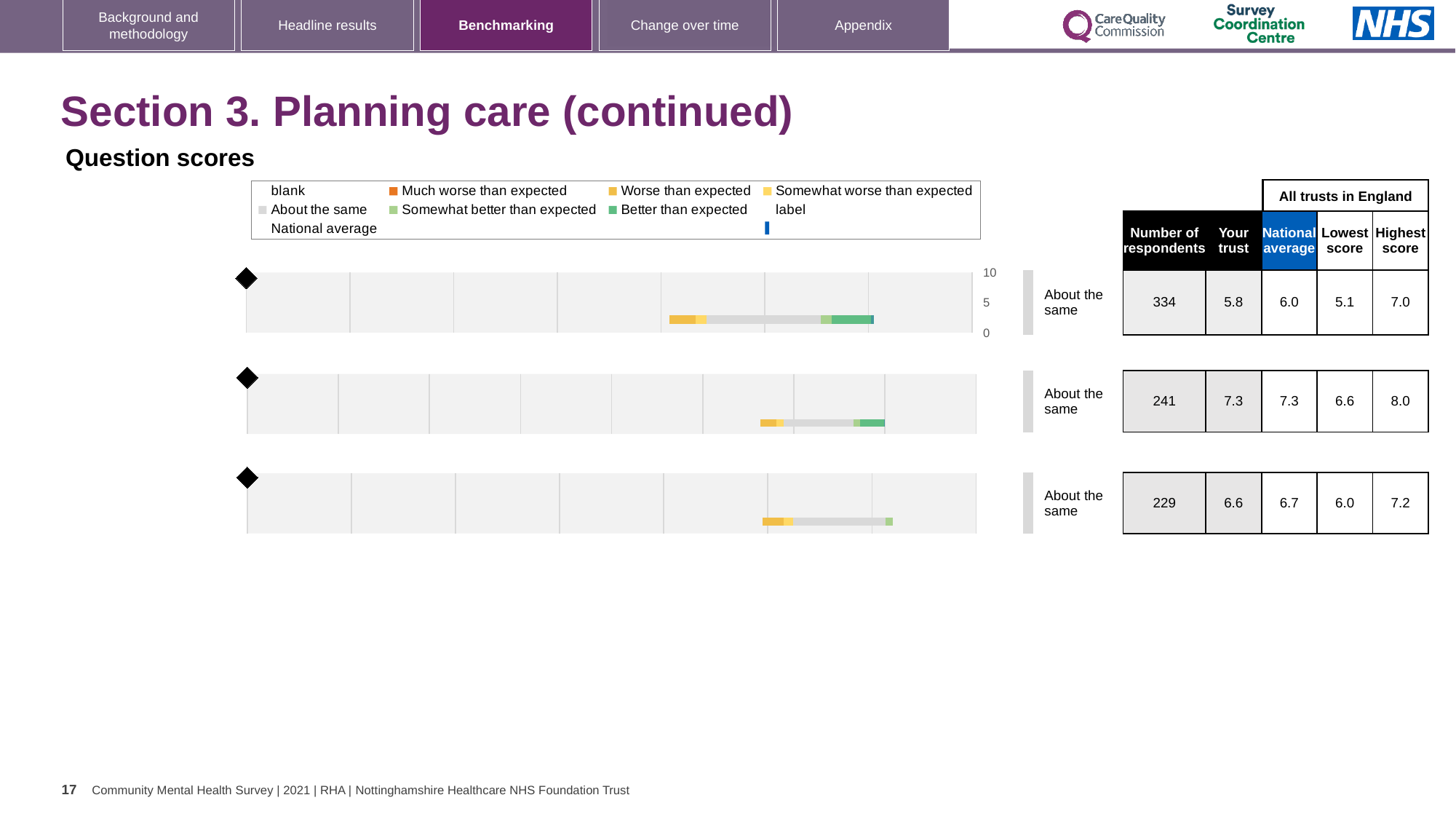
For the middle chart, what is the lowest score among all trusts in England? 6.6 For the top chart, what is the number of respondents shown in the table? 334 For the bottom chart, which is larger: the 'Your trust' score or the national average? National average For the bottom chart, what is the highest score among all trusts in England? 7.2 For the top chart, what is the 'Your trust' score? 5.8 What is the maximum value shown on the vertical axis of the top chart? 10 For the top chart, what is the difference between the highest score and the lowest score? 1.9 How many question-score charts are shown on the slide? 3 What kind of chart is used for the three question-score charts on the slide? bar chart For the middle chart, what is the national average score? 7.3 What benchmark category is shown next to the bottom chart? About the same Which of the three charts has the largest number of respondents? The top chart (334)